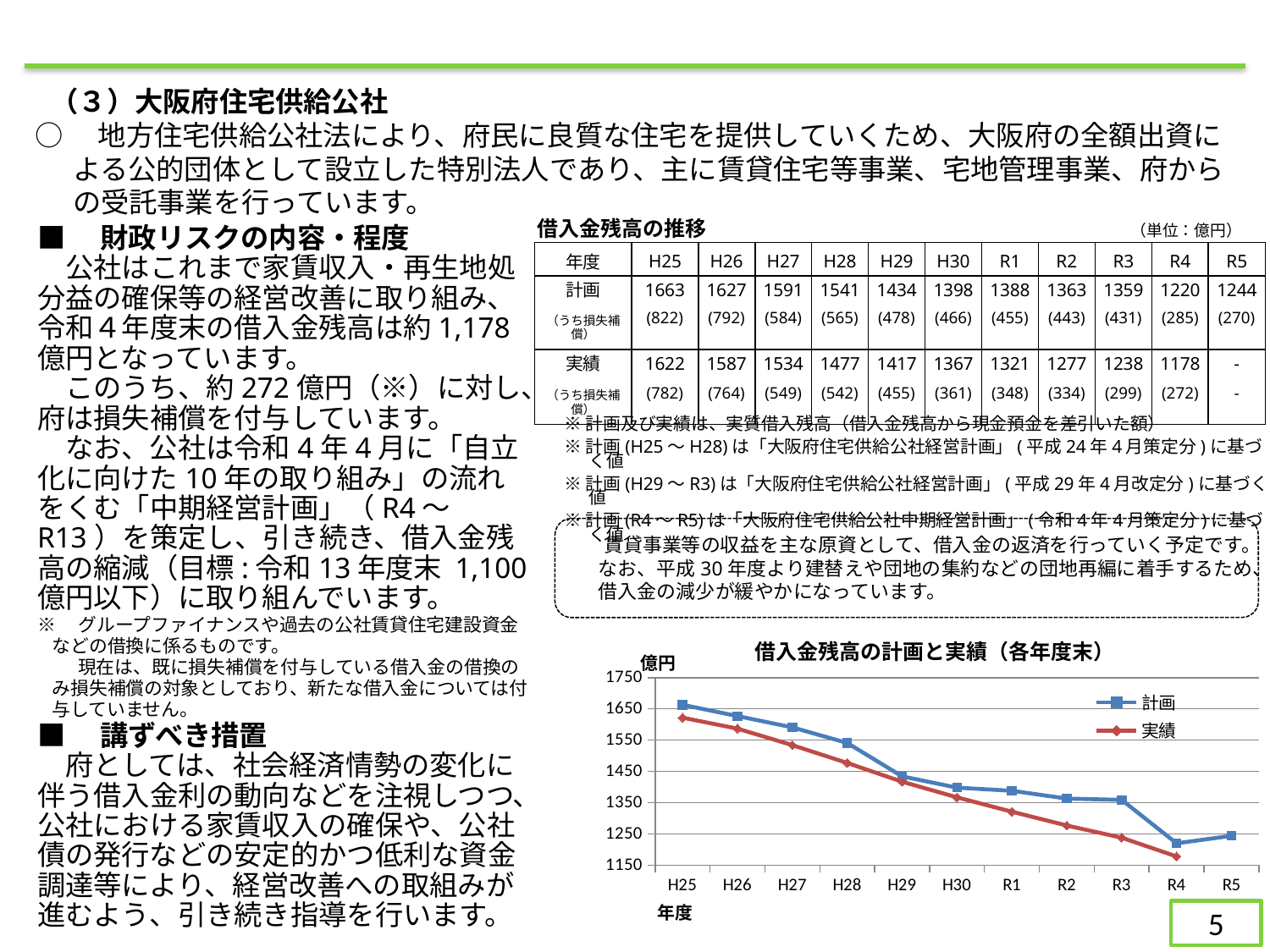
Using the table values, what is the difference between 計画 and 実績 for R4? 42 How many fiscal years are shown along the x axis of the chart? 11 Is the 計画 value for H28 greater or less than 1450? greater In which fiscal year is the 実績 value lowest? R4 How many series does the legend of the chart list? 2 What is the 実績 value for R4 as given in the table on the slide? 1178 What are the two series named in the chart legend? 計画 and 実績 Is the 実績 value for R4 greater or less than 1250? less What kind of chart is shown on the slide? line chart Does the 実績 series rise or fall from H25 to R4? fall In which fiscal year is the 実績 value highest? H25 At H28, which series has the higher value, 計画 or 実績? 計画